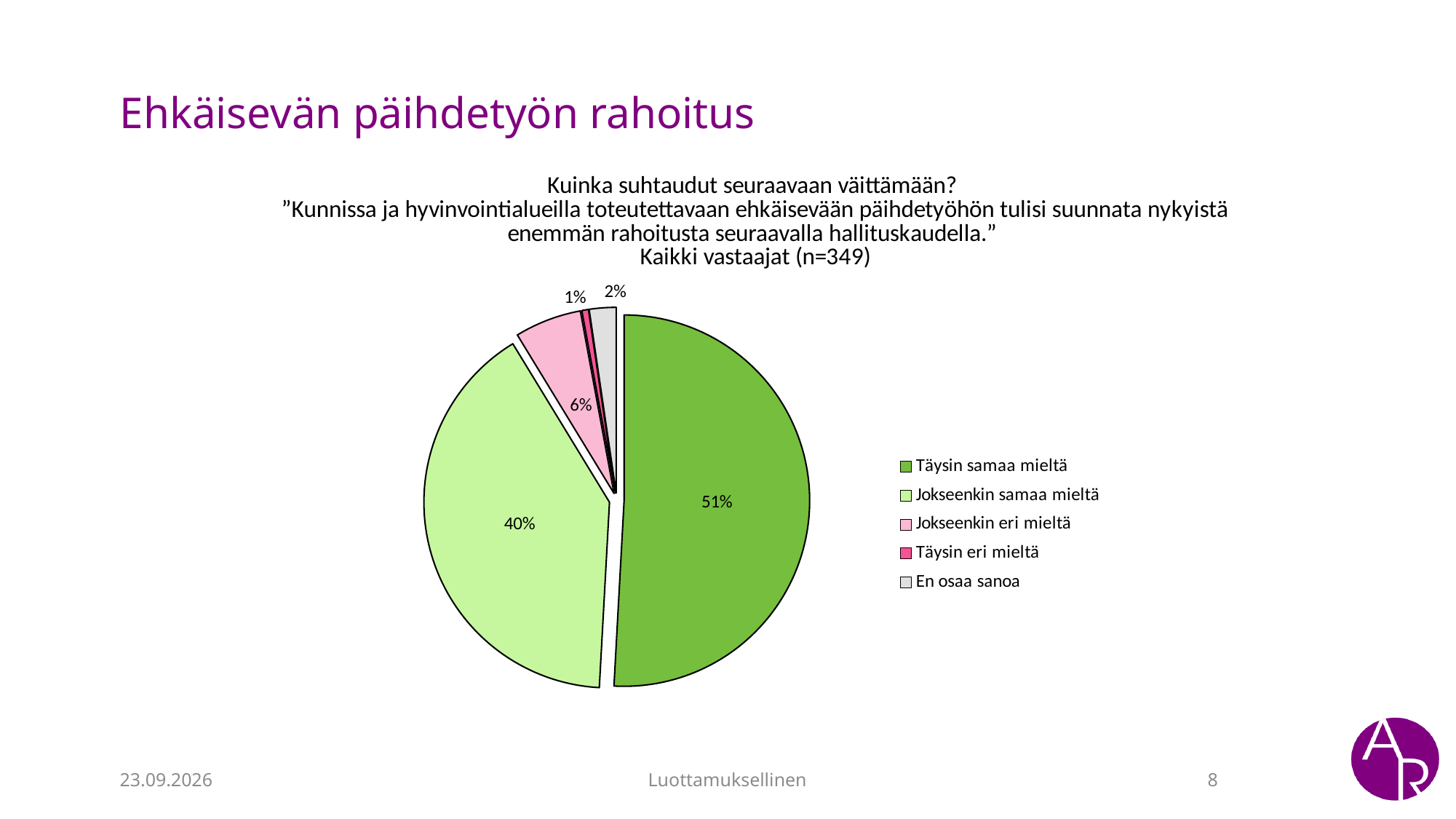
Which response category has the smallest share of the pie? Täysin eri mieltä What share of respondents answered "Täysin samaa mieltä"? 51% How many categories does the legend list? 5 How many respondents (n) does the chart subtitle state? 349 What share of respondents answered "En osaa sanoa"? 2% What is the difference in percentage points between "Täysin samaa mieltä" and "Jokseenkin samaa mieltä"? 11 percentage points What share of respondents answered "Jokseenkin eri mieltä"? 6% Which is larger, the share for "Jokseenkin eri mieltä" or the share for "En osaa sanoa"? Jokseenkin eri mieltä What share of respondents answered "Jokseenkin samaa mieltä"? 40% Which response category has the largest share of the pie? Täysin samaa mieltä What share of respondents answered "Täysin eri mieltä"? 1% What kind of chart is shown on the slide? Pie chart